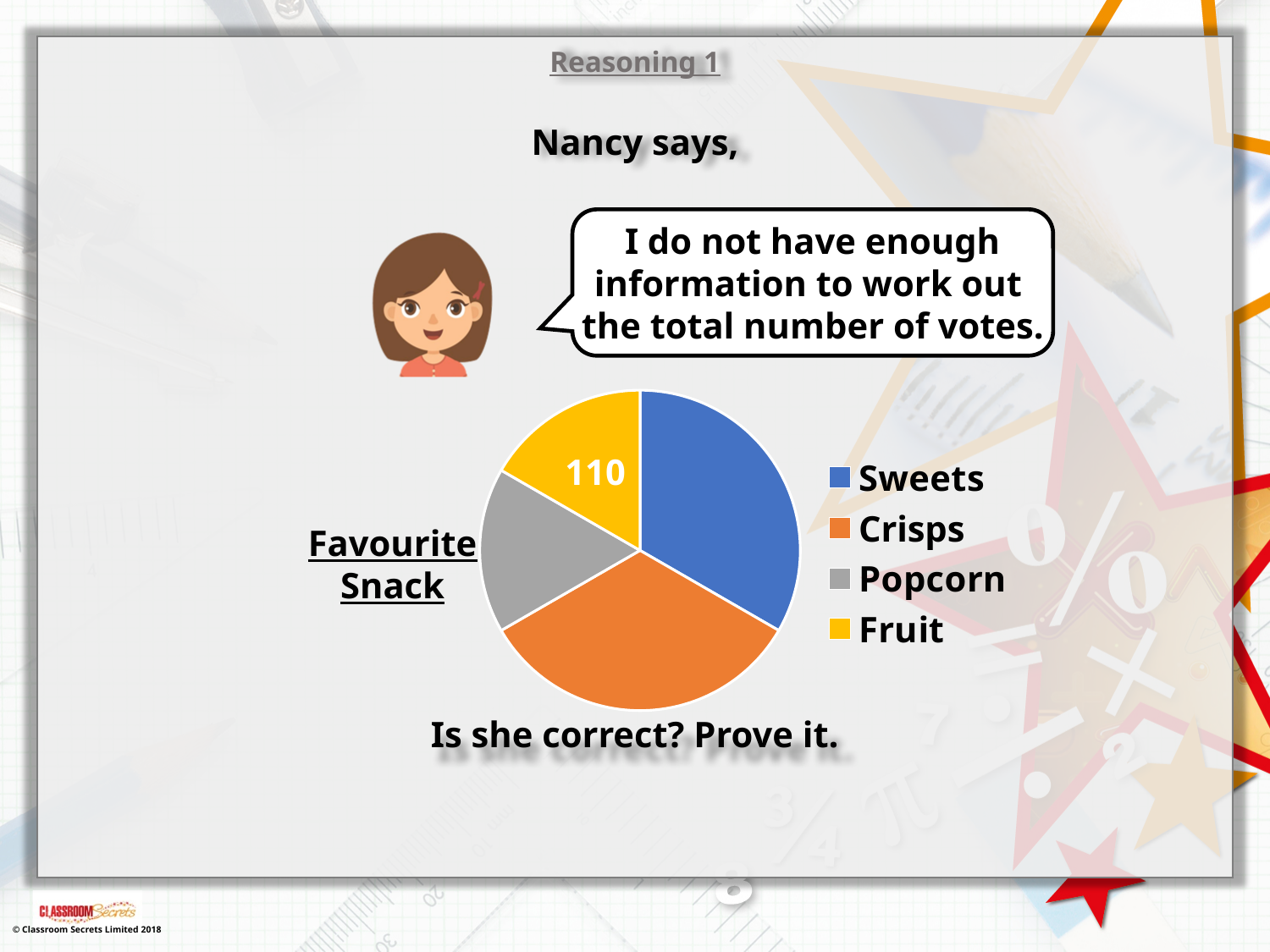
Which slice of the pie chart is larger, Crisps or Popcorn? Crisps Which slice of the pie chart is larger, Crisps or Fruit? Crisps What kind of chart is shown on the slide? pie chart What value is printed on the Fruit slice of the pie chart? 110 What is the title of the chart? Favourite Snack How many categories does the pie chart have? 4 Which slice of the pie chart is larger, Sweets or Fruit? Sweets How many entries does the legend list? 4 Which category is the only one with a value printed on its slice? Fruit What colour represents Popcorn in the pie chart? grey